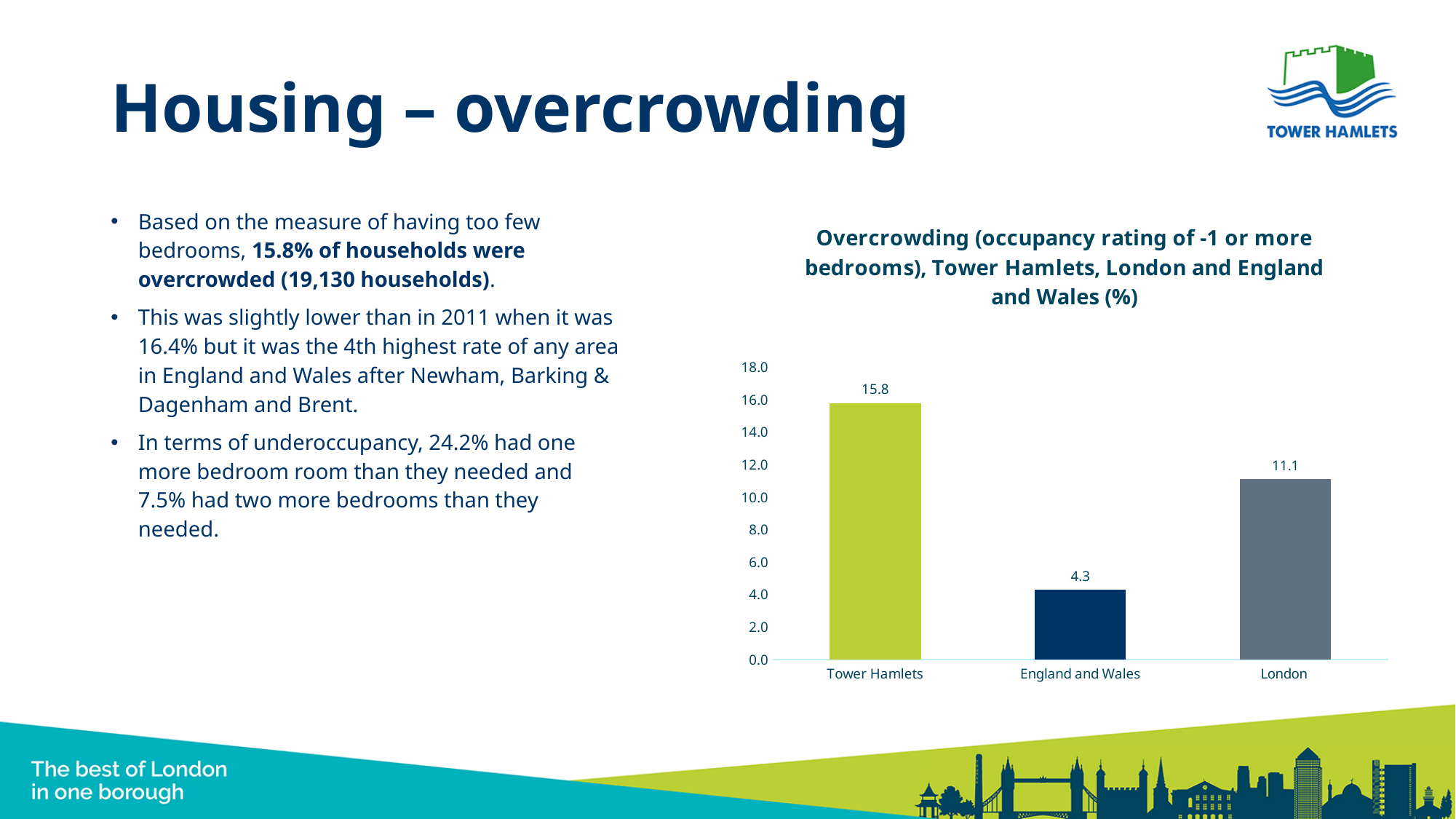
Is the value for Tower Hamlets greater or less than 14.0? greater What kind of chart is shown on the slide? bar chart What is the overcrowding value for London? 11.1 What is the overcrowding value for Tower Hamlets? 15.8 Which area has the highest overcrowding value? Tower Hamlets How many areas are shown in the chart? 3 What is the difference between the overcrowding values for London and England and Wales? 6.8 What colour is the bar for Tower Hamlets? green Which area has the lowest overcrowding value? England and Wales What is the overcrowding value for England and Wales? 4.3 What is the difference between the overcrowding values for Tower Hamlets and London? 4.7 Which has a higher overcrowding value, London or England and Wales? London